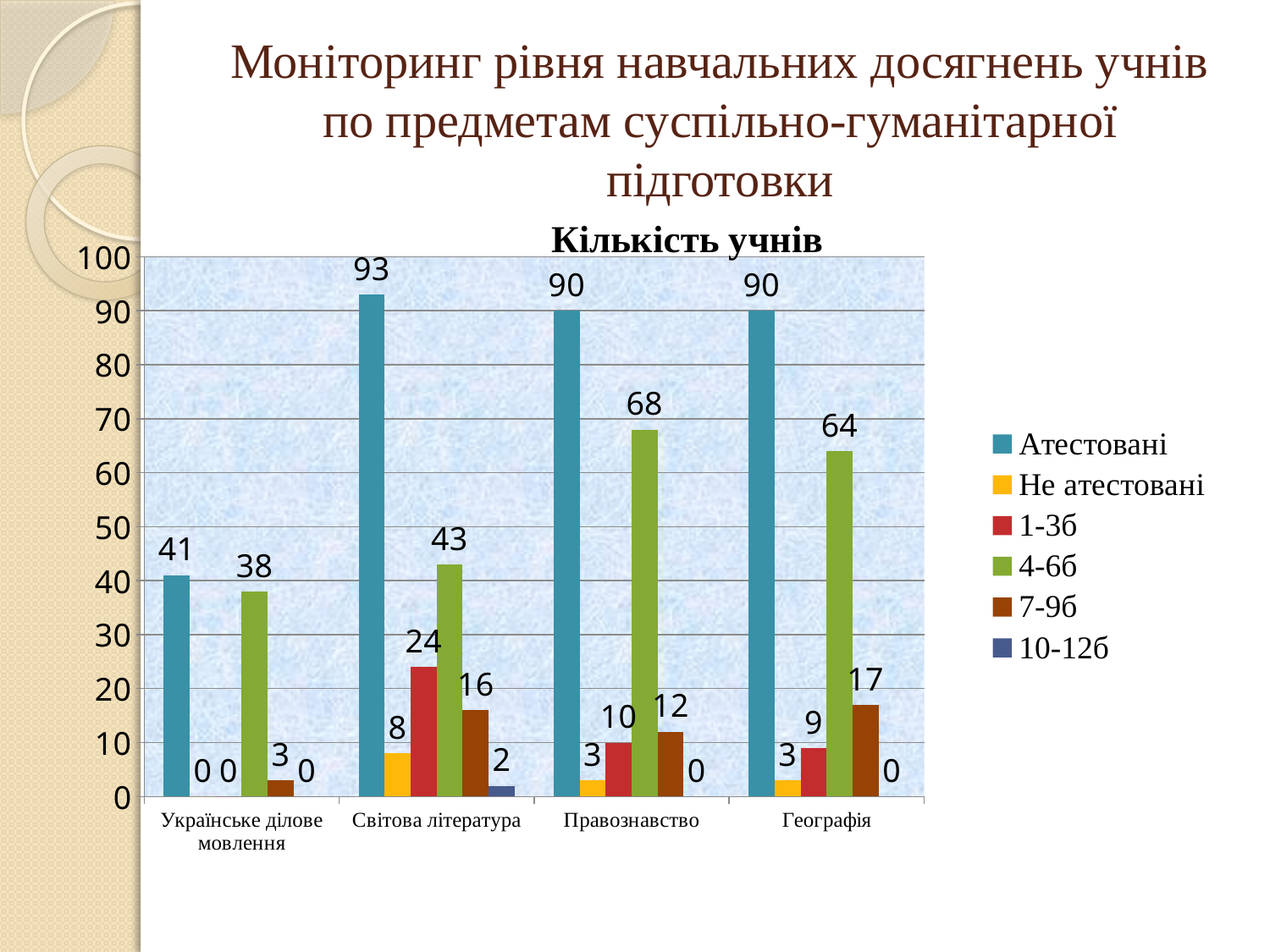
How many subject categories are shown on the x axis? 4 What is the title of the chart? Кількість учнів What is the value of Атестовані for Світова література? 93 What is the value of 1-3б for Світова література? 24 Which subject has the lowest value for 4-6б? Українське ділове мовлення What is the value of 7-9б for Географія? 17 How many series does the legend list? 6 What is the value of 4-6б for Правознавство? 68 What is the difference between the Атестовані value and the 4-6б value for Географія? 26 Which is larger: the 1-3б value for Правознавство or the 1-3б value for Географія? Правознавство Which subject has the highest value for Атестовані? Світова література What type of chart is shown on the slide? bar chart